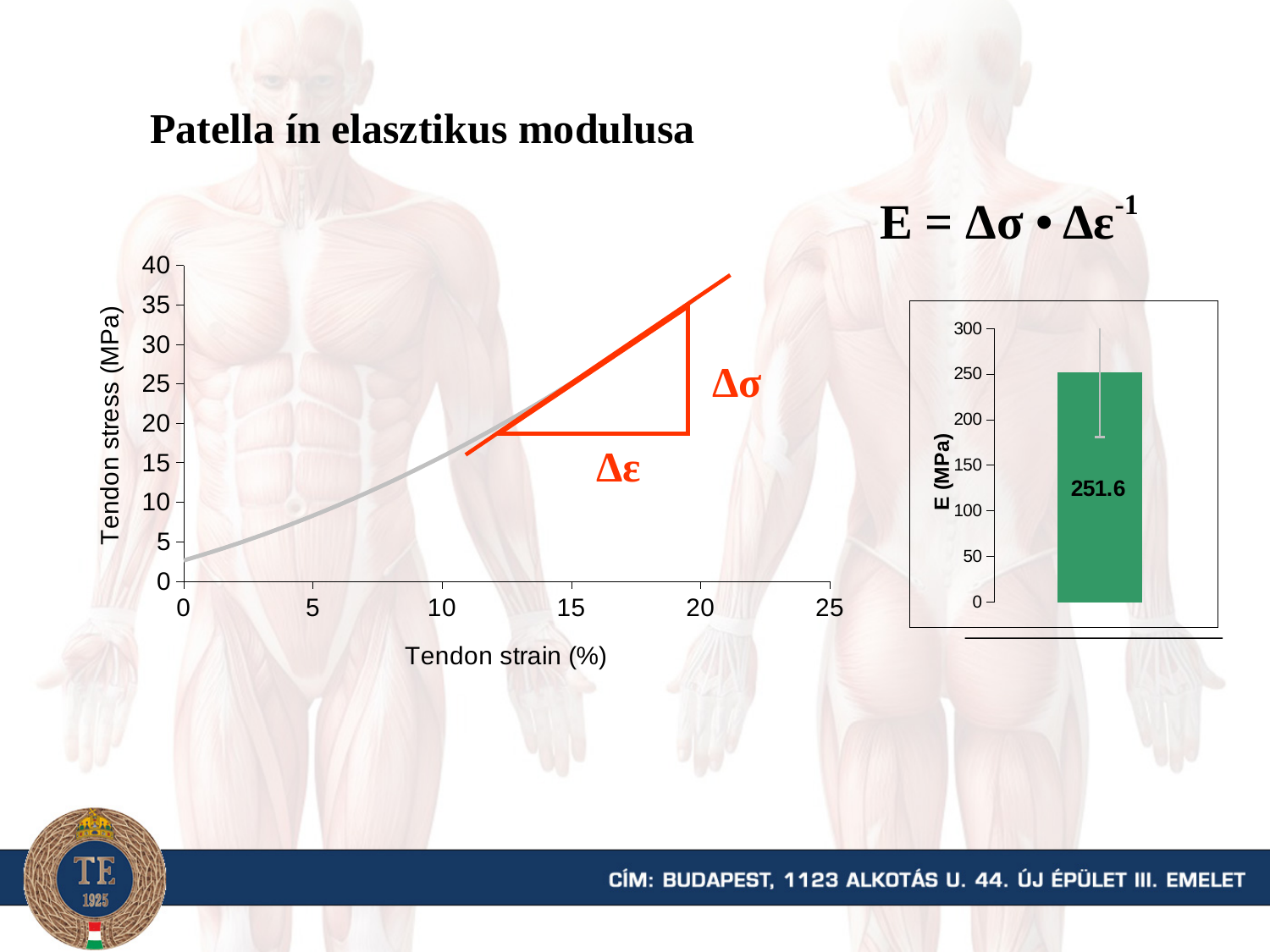
What is the y-axis label of the bar chart on the right of the slide? E (MPa) How many bars does the bar chart on the right of the slide show? 1 What kind of chart is the chart on the right of the slide (E (MPa))? bar chart What kind of chart is the chart on the left of the slide (Tendon stress vs Tendon strain)? line chart What is the x-axis label of the line chart on the left of the slide? Tendon strain (%) In the line chart on the left of the slide, is the tendon stress at a tendon strain of 10% greater or less than 20 MPa? less In the bar chart on the right of the slide, is the bar's value greater or less than 300? less In the line chart on the left of the slide, does tendon stress rise or fall as tendon strain increases? rise In the bar chart on the right of the slide, what value is printed on the bar? 251.6 In the bar chart on the right of the slide, is the bar's value greater or less than 200? greater What is the highest tick value shown on the y-axis of the line chart on the left of the slide? 40